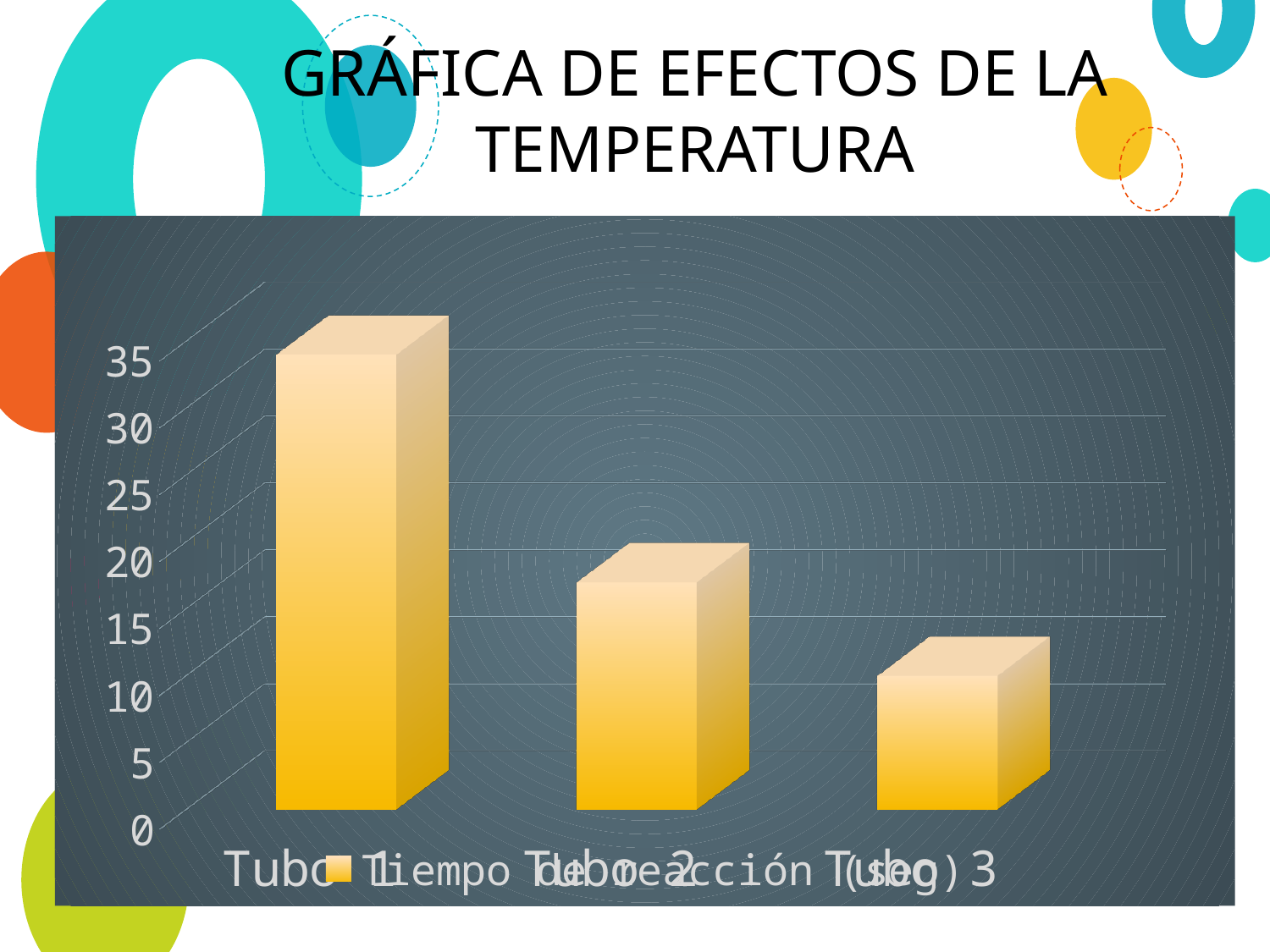
What kind of chart is shown on the slide? Bar chart Which category has the lowest value? Tubo 3 Do the values rise or fall from Tubo 1 to Tubo 3? fall How many bars (categories) does the chart show? 3 Which is larger, the value for Tubo 1 or the value for Tubo 2? Tubo 1 Is the value for Tubo 2 greater or less than 25? less Which is larger, the value for Tubo 2 or the value for Tubo 3? Tubo 2 Is the value for Tubo 1 greater or less than 30? greater How many series does the legend list? 1 What is the title of the chart on the slide? GRÁFICA DE EFECTOS DE LA TEMPERATURA Which category has the highest value? Tubo 1 Is the value for Tubo 3 greater or less than 15? less